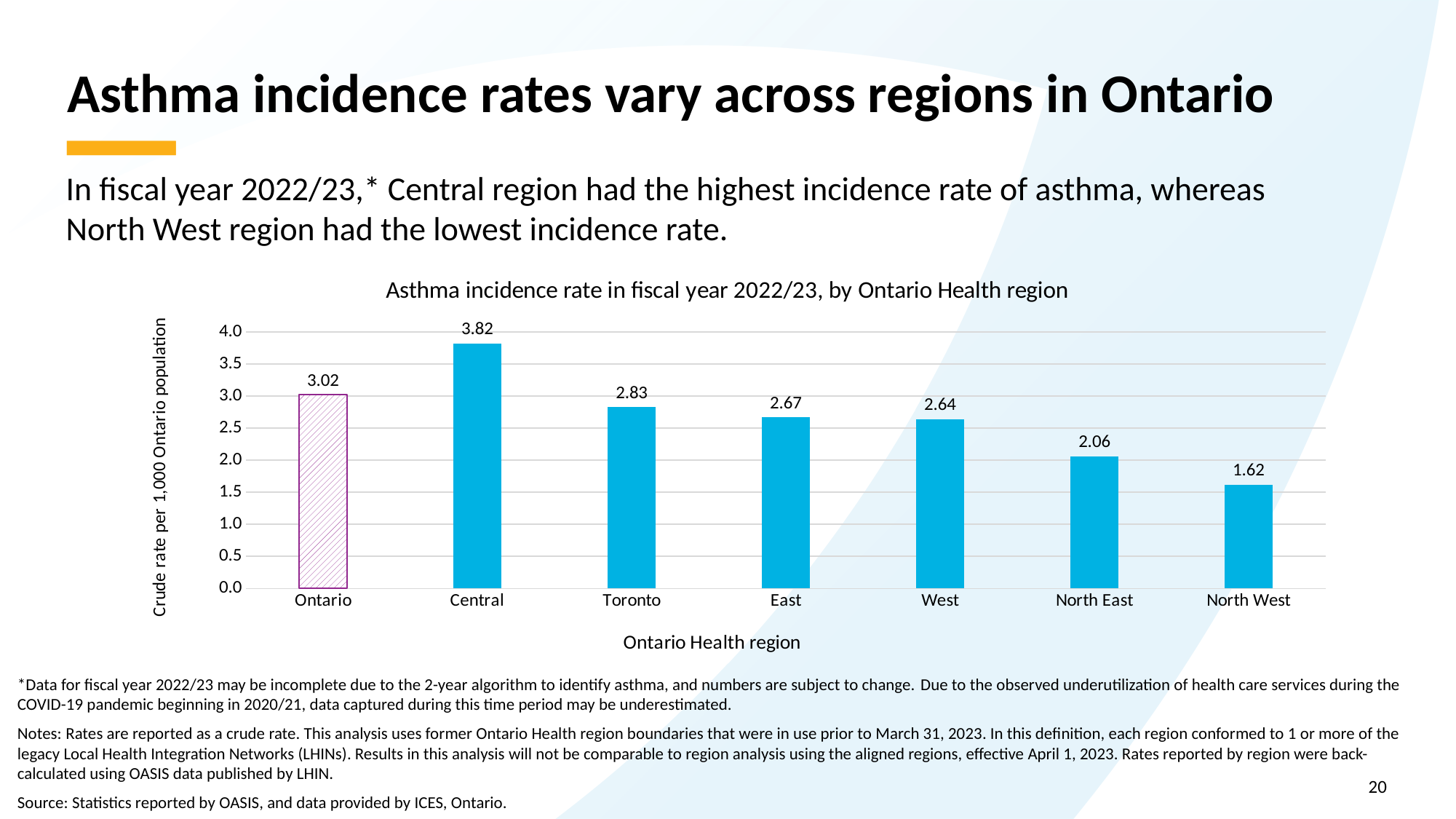
Which region has the lowest asthma incidence rate? North West What is the asthma incidence rate for the Central region? 3.82 What is the difference between the Central and North West incidence rates? 2.20 What is the asthma incidence rate for Ontario overall? 3.02 How many bars are shown in the chart? 7 What type of chart is shown on the slide? Bar chart Is the value for North West greater or less than 2.0? less Which has a higher asthma incidence rate, Toronto or West? Toronto What is the difference between the Toronto and East incidence rates? 0.16 What is the title of the chart? Asthma incidence rate in fiscal year 2022/23, by Ontario Health region Which region has the highest asthma incidence rate? Central What is the asthma incidence rate for the North East region? 2.06